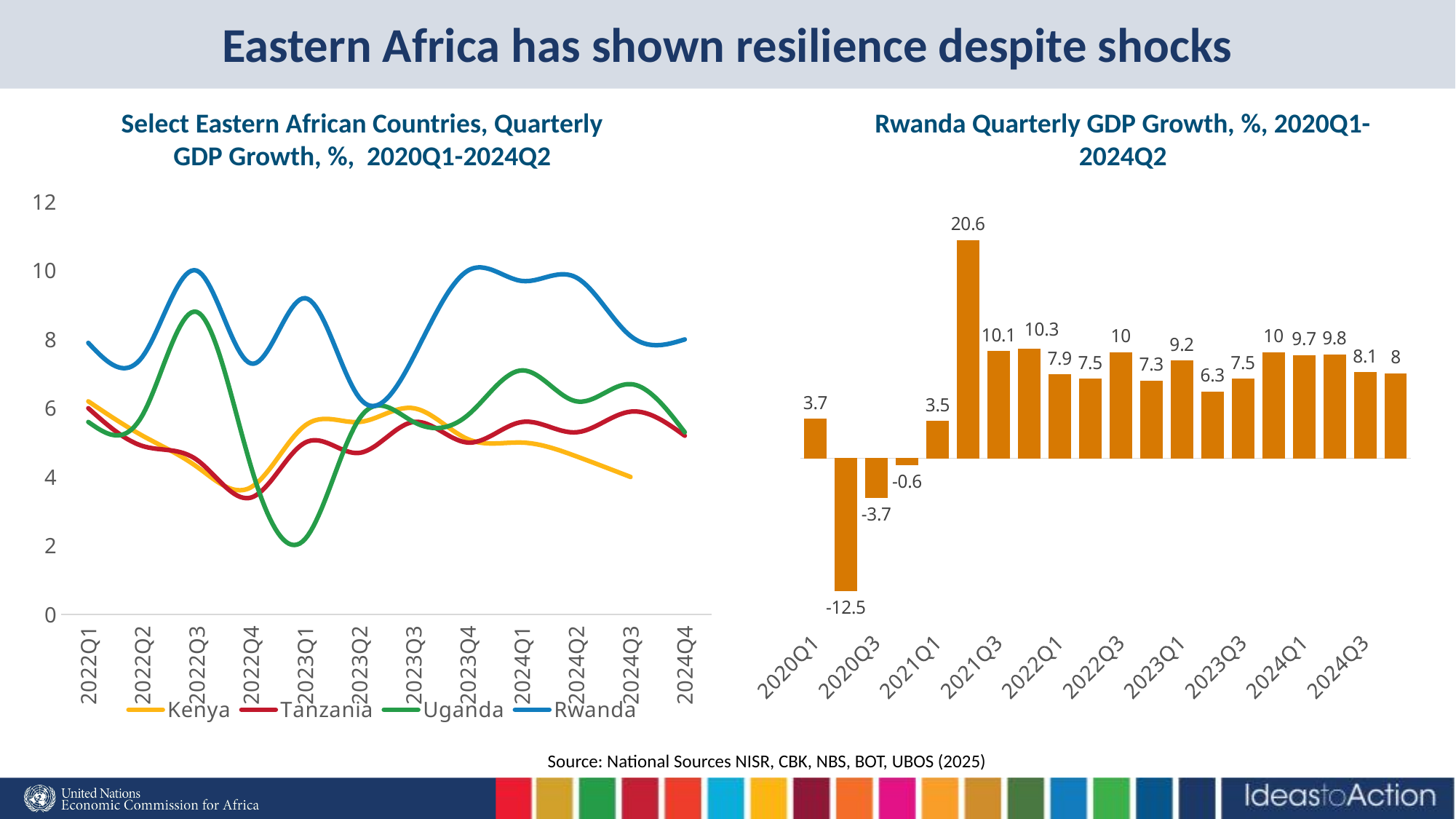
In the right chart, what is the lowest value shown? -12.5 In the right chart, what is Rwanda's GDP growth for 2020Q1? 3.7 What kind of chart is the right chart, 'Rwanda Quarterly GDP Growth'? Bar chart In the right chart, which is larger, the value for 2022Q1 or the value for 2023Q1? 2023Q1 In the left chart, is Kenya's value at 2024Q3 greater or less than 6? less What kind of chart is the left chart, 'Select Eastern African Countries, Quarterly GDP Growth'? Line chart In the right chart, what is the highest value shown? 20.6 In the right chart, what is Rwanda's GDP growth for 2021Q3? 10.1 In the right chart, what is the difference between the values for 2021Q3 and 2020Q1? 6.4 How many series does the legend of the left chart list? 4 In the left chart, which country has the highest GDP growth at 2022Q3? Rwanda